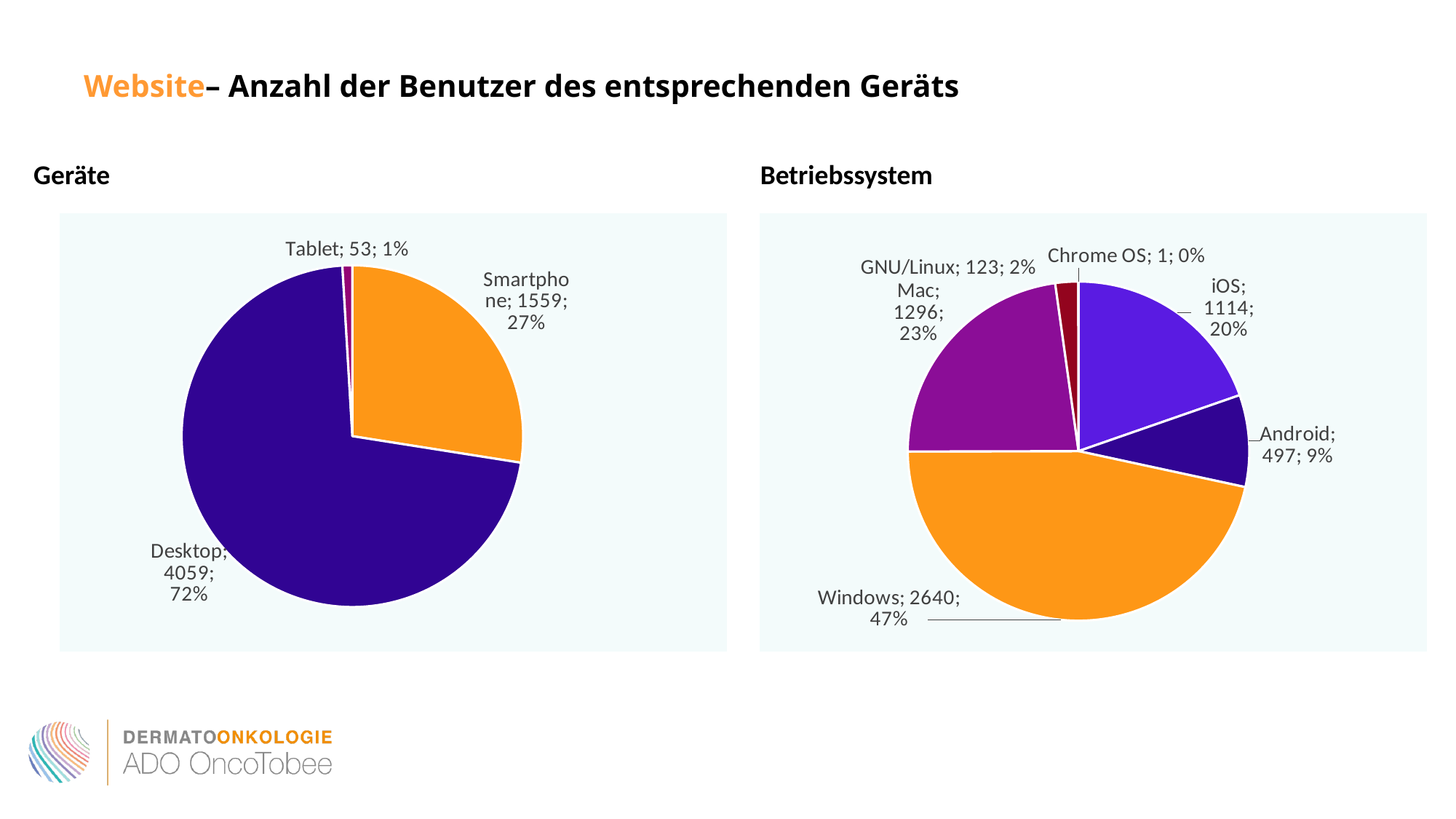
In the Betriebssystem chart, how many users are shown for Windows? 2640 In the Betriebssystem chart, which category has the smallest slice? Chrome OS In the Geräte chart, which category has the smallest slice? Tablet What kind of chart is the Geräte chart? Pie chart In the Geräte chart, how many users are shown for Desktop? 4059 In the Betriebssystem chart, which category has the largest slice? Windows In the Geräte chart, what is the difference in users between Smartphone and Tablet? 1506 In the Geräte chart, how many categories are shown? 3 In the Betriebssystem chart, which has more users, iOS or Android? iOS In the Betriebssystem chart, what share of the pie does Mac have? 23% In the Betriebssystem chart, how many categories are shown? 6 In the Geräte chart, what share of the pie does Smartphone have? 27%